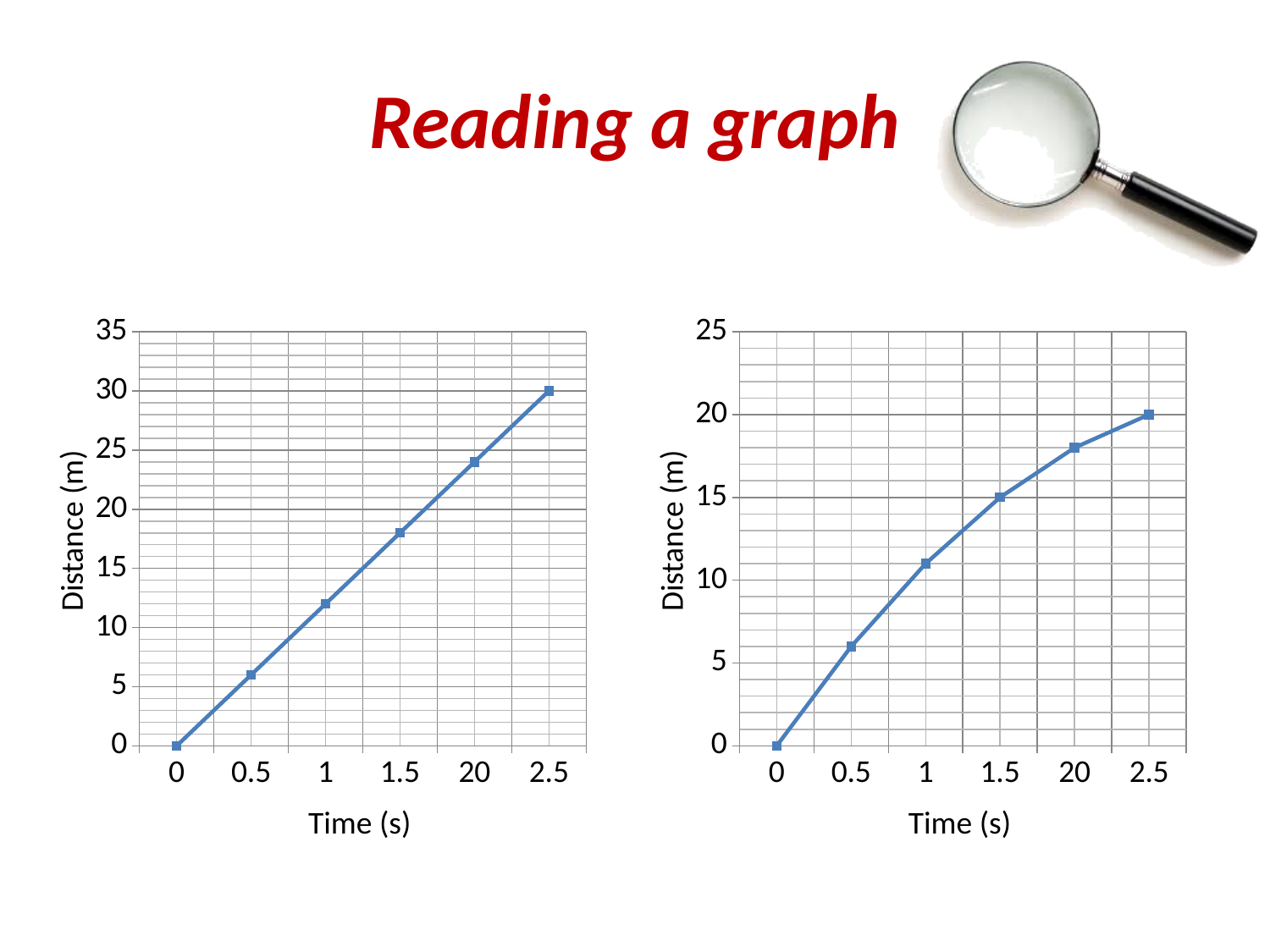
On the left chart, what is the distance at time 2.5? 30 On the left chart, how many data points are plotted? 6 On the left chart, does the distance rise or fall as time increases? rise What kind of chart is the chart on the left of the slide? line chart On the right chart, at which time is the distance highest? 2.5 On the right chart, is the distance at time 0.5 greater or less than 5? greater On the right chart, what is the distance at time 1.5? 15 On the left chart, what is the distance at time 0? 0 On the right chart, what is the distance at time 2.5? 20 On the right chart, what is the difference between the distance at time 2.5 and the distance at time 1.5? 5 On the left chart, is the distance at time 1 greater or less than 10? greater What is the y-axis title of the right chart? Distance (m)